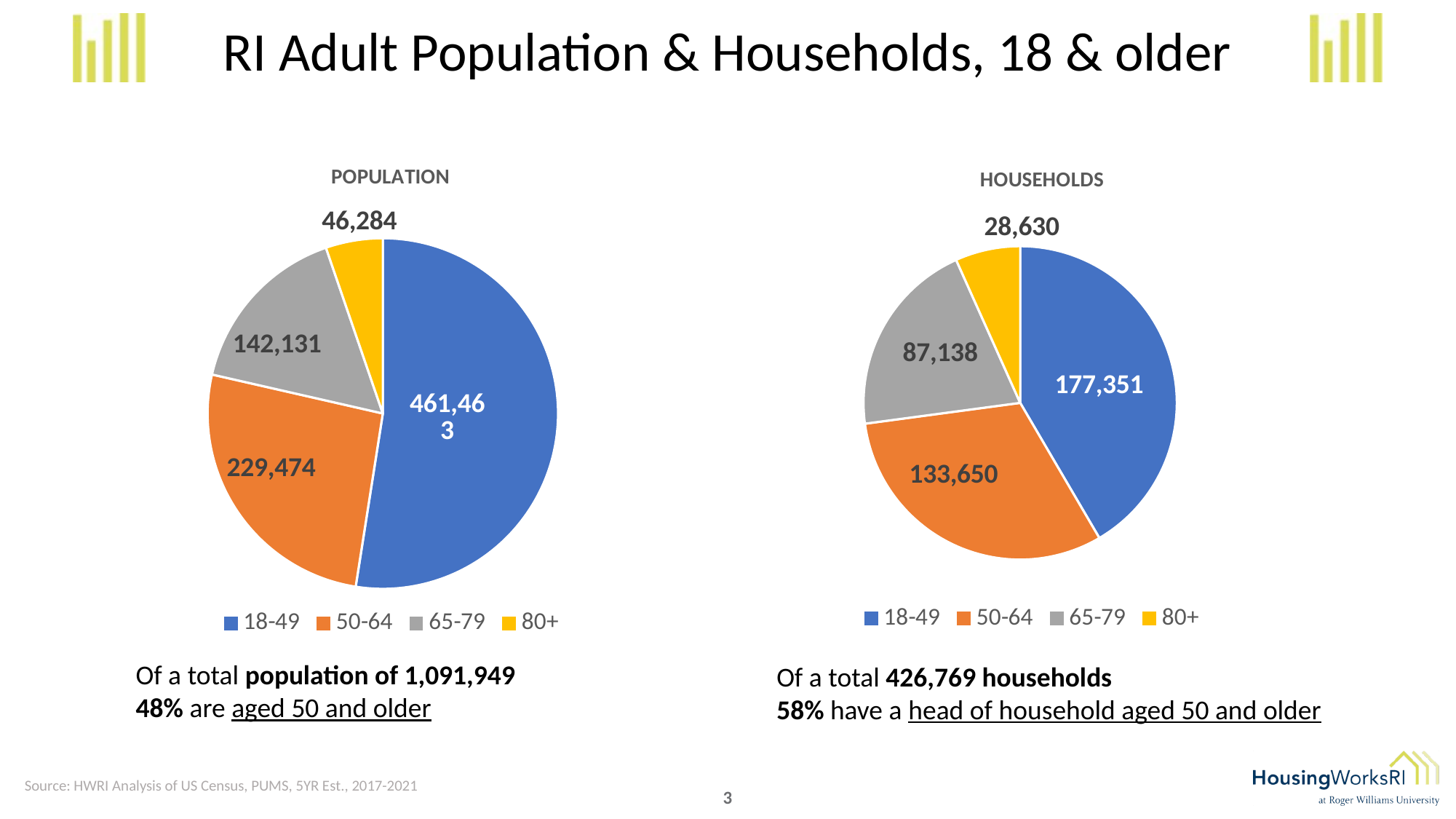
In the POPULATION pie chart, which colour represents the 50-64 age group? Orange In the HOUSEHOLDS pie chart, which is larger: the 65-79 slice or the 80+ slice? 65-79 In the POPULATION pie chart, what is the value for the 65-79 age group? 142,131 In the HOUSEHOLDS pie chart, what is the difference between the 18-49 value and the 50-64 value? 43,701 What type of chart is used for HOUSEHOLDS? Pie chart In the HOUSEHOLDS pie chart, which age group has the smallest slice? 80+ How many age groups are shown in the POPULATION pie chart? 4 In the POPULATION pie chart, which age group has the largest slice? 18-49 In the POPULATION pie chart, what is the difference between the 18-49 value and the 50-64 value? 231,989 In the HOUSEHOLDS pie chart, what is the value for the 80+ age group? 28,630 In the HOUSEHOLDS pie chart, what is the value for the 50-64 age group? 133,650 In the POPULATION pie chart, what is the value for the 18-49 age group? 461,463